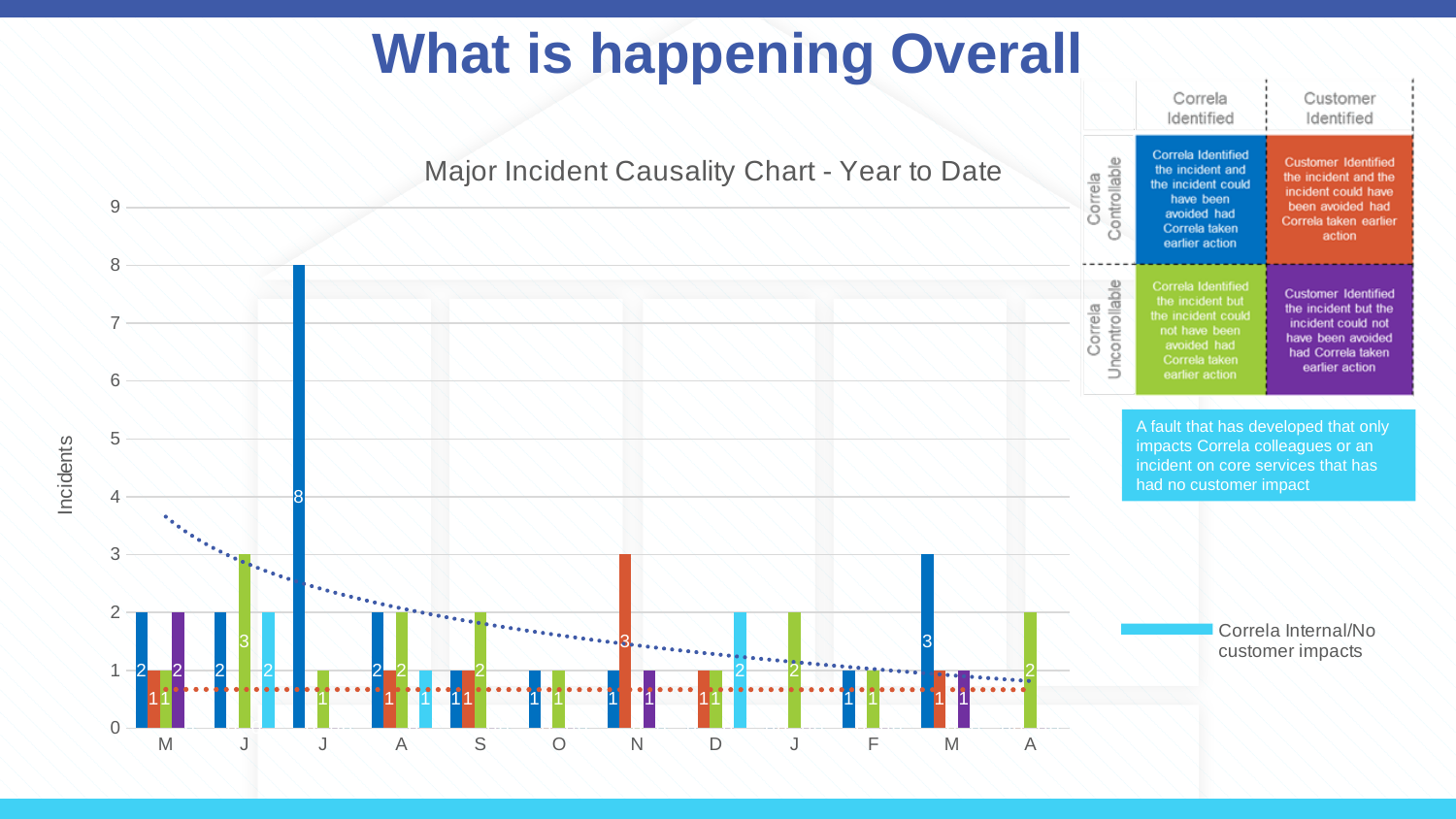
Is the value of the tallest bar in the chart greater or less than 5? greater What is the title of the chart on the slide? Major Incident Causality Chart - Year to Date According to the legend, what does the light blue colour represent? Correla Internal/No customer impacts What is the value of the light blue bar in the D month? 2 What kind of chart is the Major Incident Causality Chart? Bar chart Which month has the larger dark blue bar, the second M month (March) or the F month? M (March) What is the value of the dark blue bar in the second J month (July)? 8 What is the value of the green bar in the first J month (June)? 3 What is the value of the orange bar in the N month? 3 How many months are shown along the x axis of the chart? 12 What is the value of the tallest bar in the chart? 8 What is the difference between the dark blue bar in the second J month (8) and the dark blue bar in the second M month (3)? 5